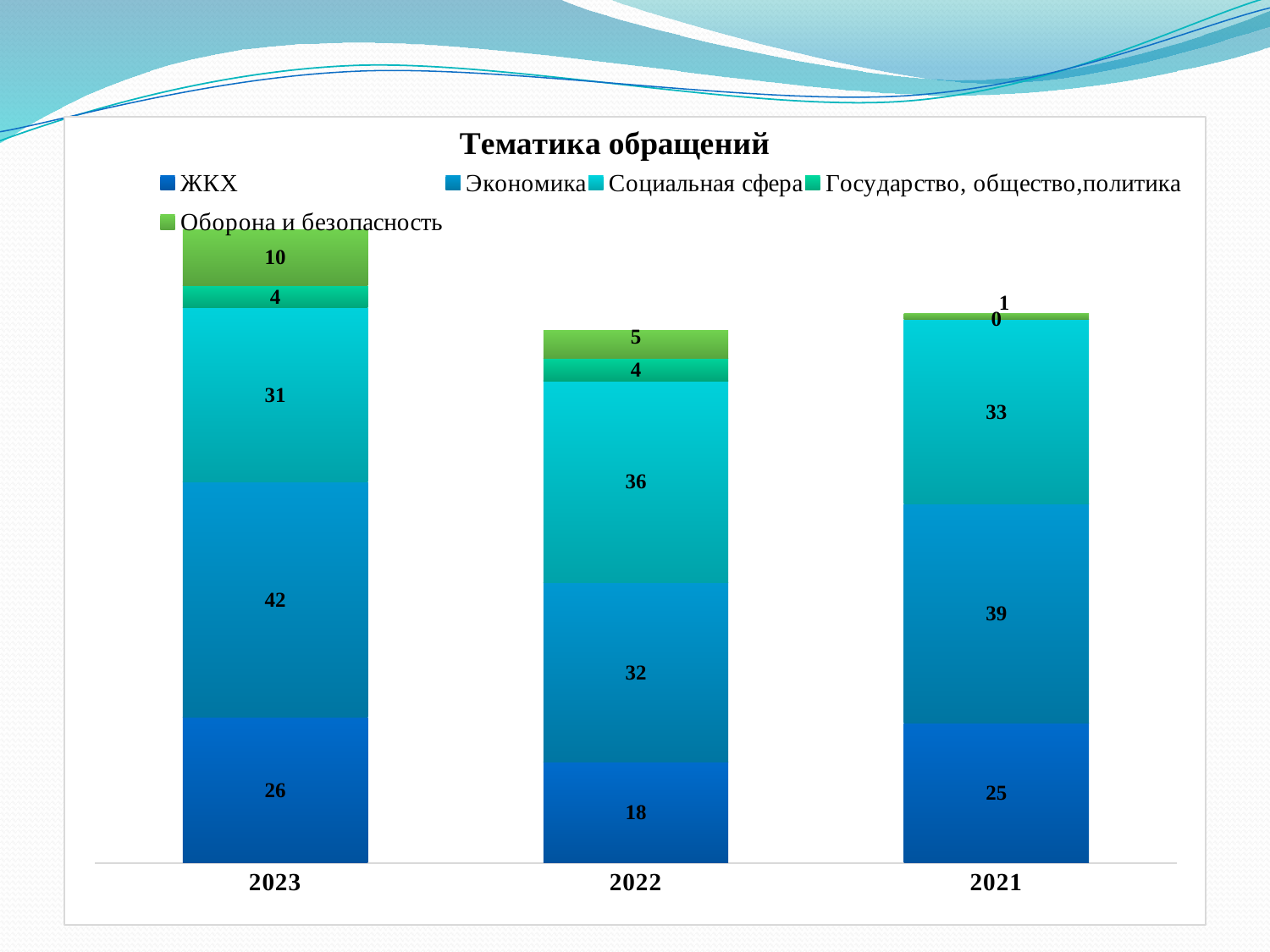
What kind of chart is shown on the slide? Stacked bar chart What is the value for Оборона и безопасность in 2023? 10 Which year has the highest value for ЖКХ? 2023 What is the total of the stacked bar for 2022? 95 What is the difference between the Экономика values for 2023 and 2022? 10 What is the value for ЖКХ in 2023? 26 Which is larger: Социальная сфера in 2022 or Социальная сфера in 2023? Социальная сфера in 2022 What is the value for Государство, общество,политика in 2021? 0 What is the value for Экономика in 2022? 32 Which year has the lowest value for Оборона и безопасность? 2021 How many series does the legend list? 5 What is the value for Социальная сфера in 2021? 33